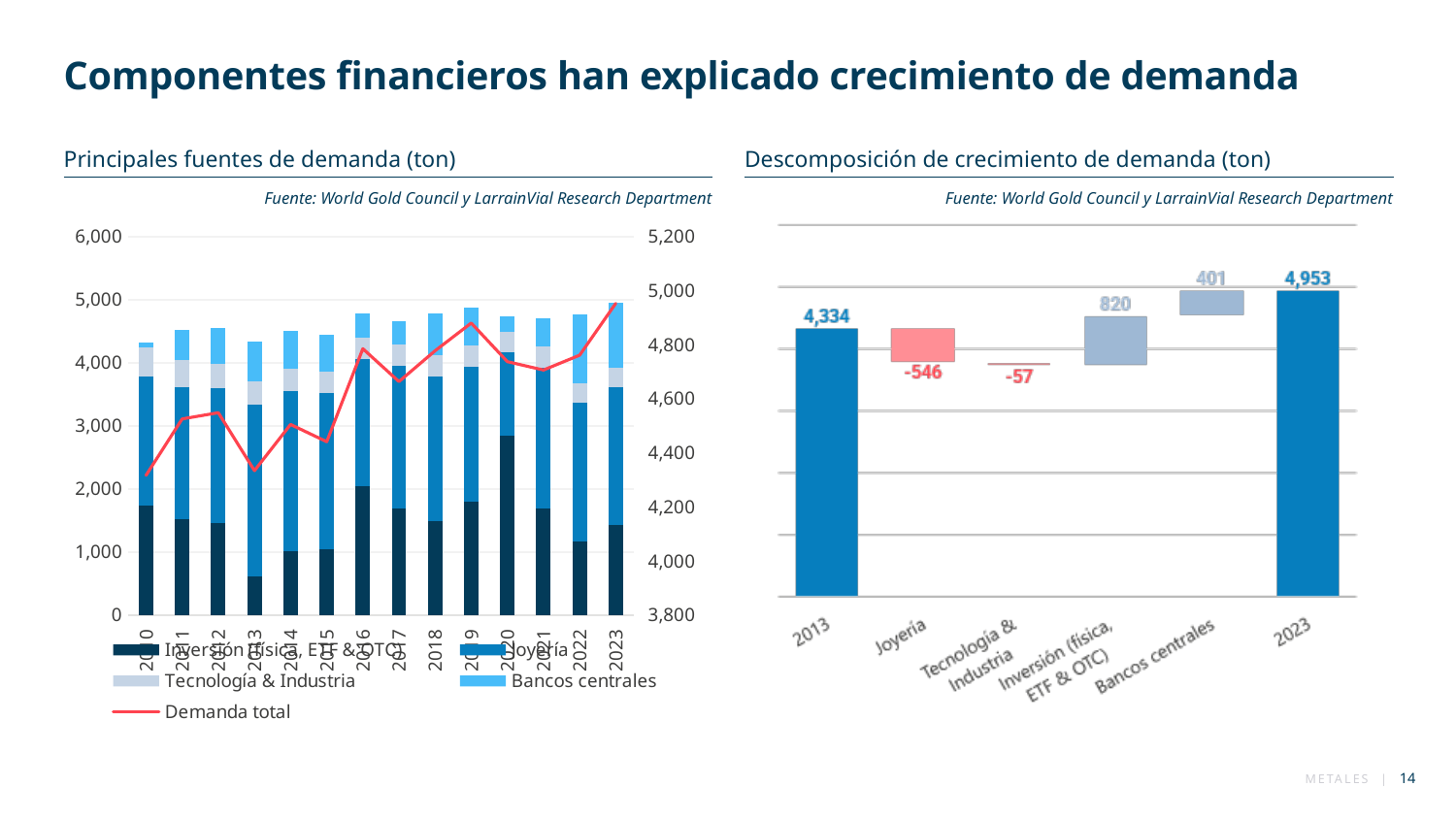
How many years are shown on the x axis of the chart 'Principales fuentes de demanda (ton)'? 14 In the chart 'Descomposición de crecimiento de demanda (ton)', what is the value shown for Tecnología & Industria? -57 In the chart 'Descomposición de crecimiento de demanda (ton)', what is the value shown for Bancos centrales? 401 In the chart 'Descomposición de crecimiento de demanda (ton)', what is the value shown for Inversión (física, ETF & OTC)? 820 In the chart 'Descomposición de crecimiento de demanda (ton)', what is the value shown for 2023? 4,953 In the chart 'Descomposición de crecimiento de demanda (ton)', which component contributes the largest positive amount? Inversión (física, ETF & OTC) In the chart 'Descomposición de crecimiento de demanda (ton)', what is the difference between the 2023 value and the 2013 value? 619 In the chart 'Descomposición de crecimiento de demanda (ton)', which is larger, the value for Bancos centrales or the value for Inversión (física, ETF & OTC)? Inversión (física, ETF & OTC) In the chart 'Descomposición de crecimiento de demanda (ton)', what is the value shown for Joyería? -546 How many series does the legend of the chart 'Principales fuentes de demanda (ton)' list? 5 In the chart 'Principales fuentes de demanda (ton)', is the total height of the stacked bar for 2023 greater or less than 4,000 on the left axis? greater In the chart 'Descomposición de crecimiento de demanda (ton)', what is the value shown for 2013? 4,334